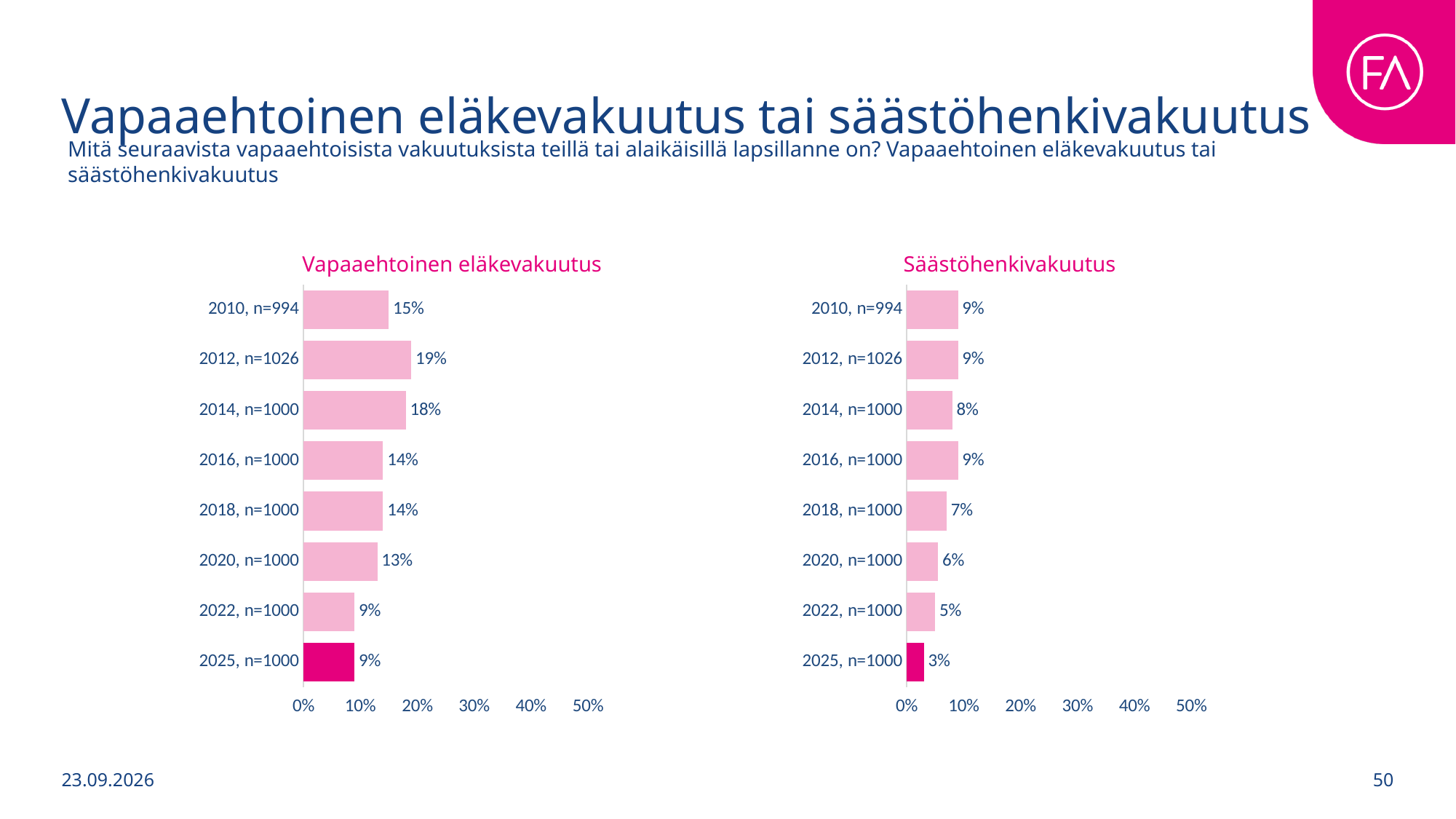
In the 'Vapaaehtoinen eläkevakuutus' chart, what is the difference between the values for 2012, n=1026 and 2025, n=1000? 10% In the 'Säästöhenkivakuutus' chart, what is the value for 2025, n=1000? 3% In the 'Vapaaehtoinen eläkevakuutus' chart, which category has the highest value? 2012, n=1026 In the 'Vapaaehtoinen eläkevakuutus' chart, which is larger: the value for 2014, n=1000 or the value for 2020, n=1000? 2014, n=1000 In the 'Säästöhenkivakuutus' chart, which category has the lowest value? 2025, n=1000 What kind of chart is the 'Säästöhenkivakuutus' chart? bar chart How many categories are shown in the 'Vapaaehtoinen eläkevakuutus' chart? 8 In the 'Säästöhenkivakuutus' chart, what is the difference between the values for 2010, n=994 and 2022, n=1000? 4% In the 'Säästöhenkivakuutus' chart, do the values generally rise or fall from 2010 to 2025? fall In the 'Säästöhenkivakuutus' chart, is the value for 2018, n=1000 greater or less than 10%? less In the 'Vapaaehtoinen eläkevakuutus' chart, what is the value for 2020, n=1000? 13% In the 'Vapaaehtoinen eläkevakuutus' chart, what is the value for 2012, n=1026? 19%